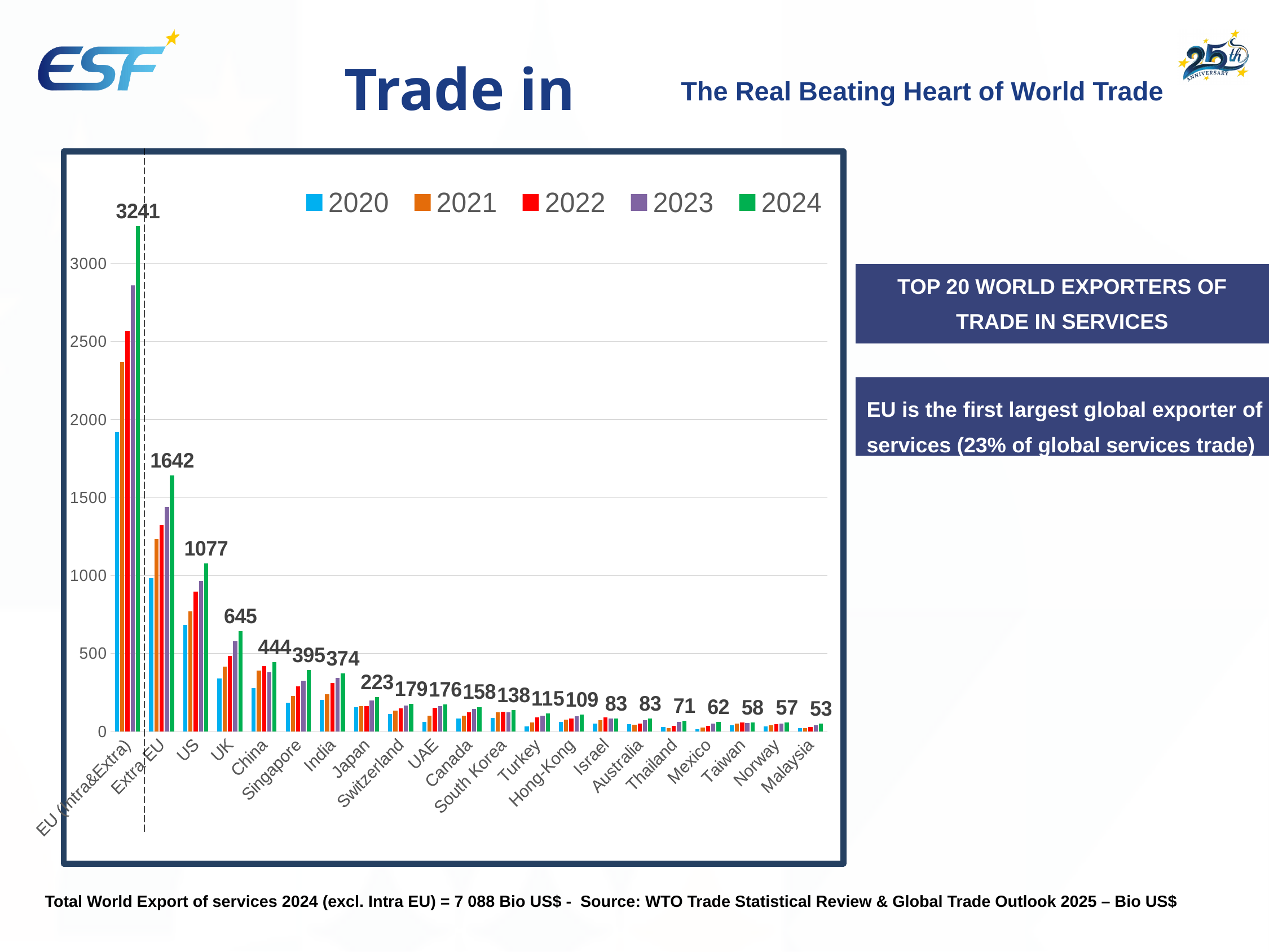
Which category has the highest 2024 value? EU (Intra&Extra) Which has a larger 2024 value, China or India? China Is the 2020 value for the US greater or less than 1000? less What is the 2024 value for Singapore? 395 How many series does the legend list? 5 What is the 2024 value for the US? 1077 How many exporter categories are shown on the x axis? 21 What type of chart is shown on the slide? bar chart What is the difference between the 2024 values for the US and the UK? 432 Which category has the lowest 2024 value? Malaysia What is the 2024 value for Extra-EU? 1642 Do the values for EU (Intra&Extra) rise or fall from 2020 to 2024? rise